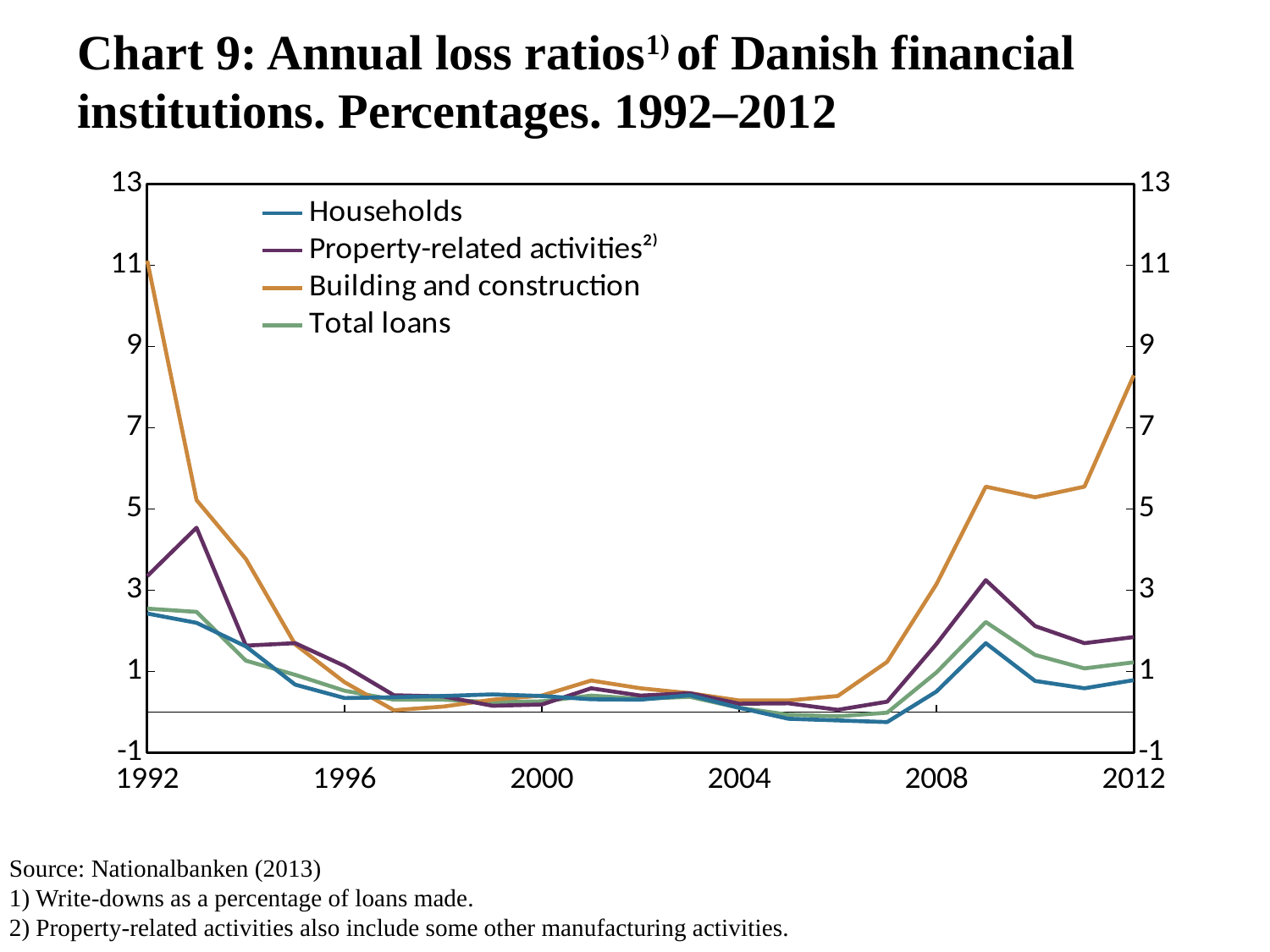
Is the value for Building and construction in 2012 greater or less than 7? greater How many series does the legend list? 4 Which series has the lowest value in 2012? Households Is the value for Building and construction in 1992 greater or less than 9? greater In 2012, which is larger: the value for Building and construction or the value for Households? Building and construction Which series is drawn in orange? Building and construction Which series has the highest value in 2012? Building and construction Which series has the highest value in 1992? Building and construction Is the value for Property-related activities in 1993 greater or less than 5? less What kind of chart is shown on the slide? Line chart Does the Building and construction series rise or fall between 1992 and 1996? Fall